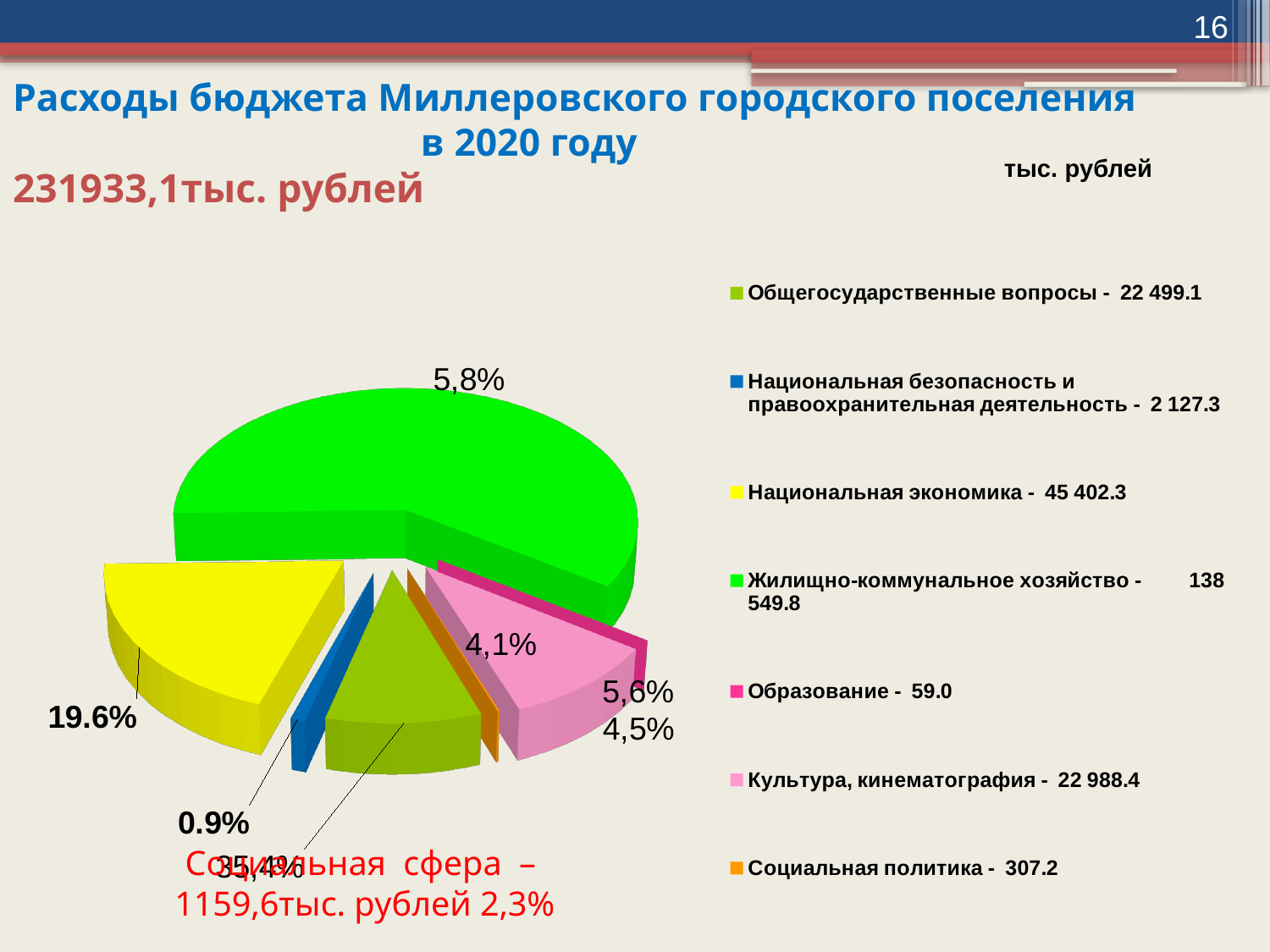
What total budget expenditure amount is stated on the slide? 231933,1тыс. рублей What is the value for Национальная экономика shown in the legend? 45 402.3 What is the value for Культура, кинематография shown in the legend? 22 988.4 Which is larger: Национальная экономика or Общегосударственные вопросы? Национальная экономика What is the difference between the values for Национальная экономика and Общегосударственные вопросы? 22 903.2 What is the value for Социальная политика shown in the legend? 307.2 What is the value for Жилищно-коммунальное хозяйство shown in the legend? 138 549.8 How many categories does the legend of the pie chart list? 7 What kind of chart is shown on the slide? pie chart What is the value for Образование shown in the legend? 59.0 Which category has the smallest value in the pie chart? Образование Which category has the largest value in the pie chart? Жилищно-коммунальное хозяйство